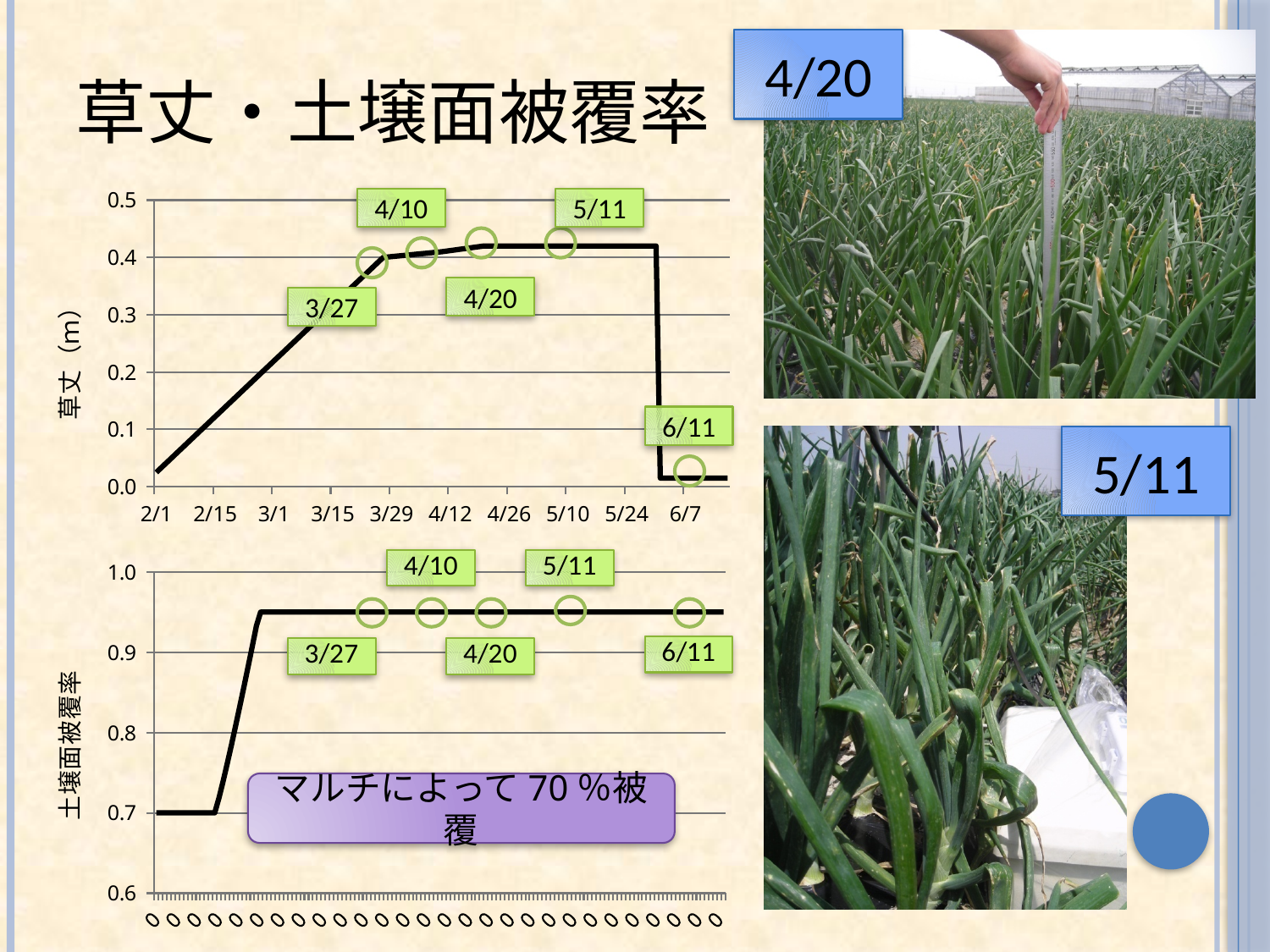
In the bottom chart (土壌面被覆率), what is the soil surface coverage rate at the start of the period (2/1)? 0.7 What kind of chart is the bottom chart (土壌面被覆率)? line chart How many dated observation points are circled on the top chart (草丈)? 5 In the bottom chart (土壌面被覆率), is the value at 6/11 greater or less than 0.8? greater What is the y-axis label of the top chart? 草丈（m） In the top chart (草丈), is the value at 3/27 greater or less than 0.3? greater In the bottom chart (土壌面被覆率), is the value at 4/10 greater or less than 0.9? greater What is the title of the slide containing the two charts? 草丈・土壌面被覆率 In the top chart (草丈), does the plant height rise or fall between 2/1 and 4/12? rise What kind of chart is the top chart (草丈)? line chart